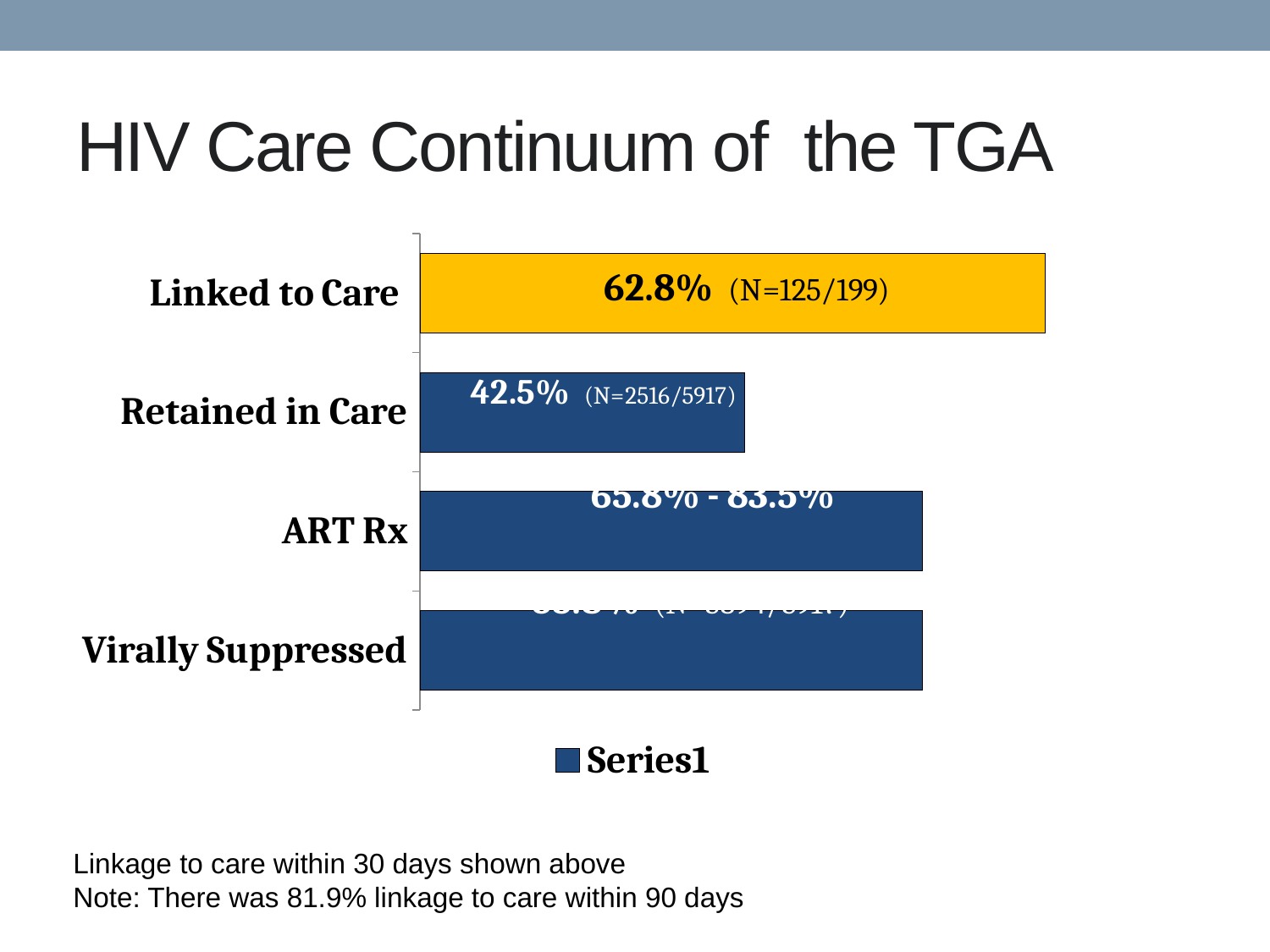
What is the title of the slide? HIV Care Continuum of the TGA What is the value shown for Retained in Care? 42.5% What is the value shown for Linked to Care? 62.8% Which is larger, the value for Linked to Care or the value for Retained in Care? Linked to Care What N is shown for Retained in Care? N=2516/5917 Which category has the shortest bar? Retained in Care How many categories are shown on the chart? 4 Which category has the longest bar? Linked to Care How many series does the legend list? 1 What N is shown for Linked to Care? N=125/199 What is the difference in percentage points between Linked to Care and Retained in Care? 20.3 What kind of chart is shown on the slide? Bar chart